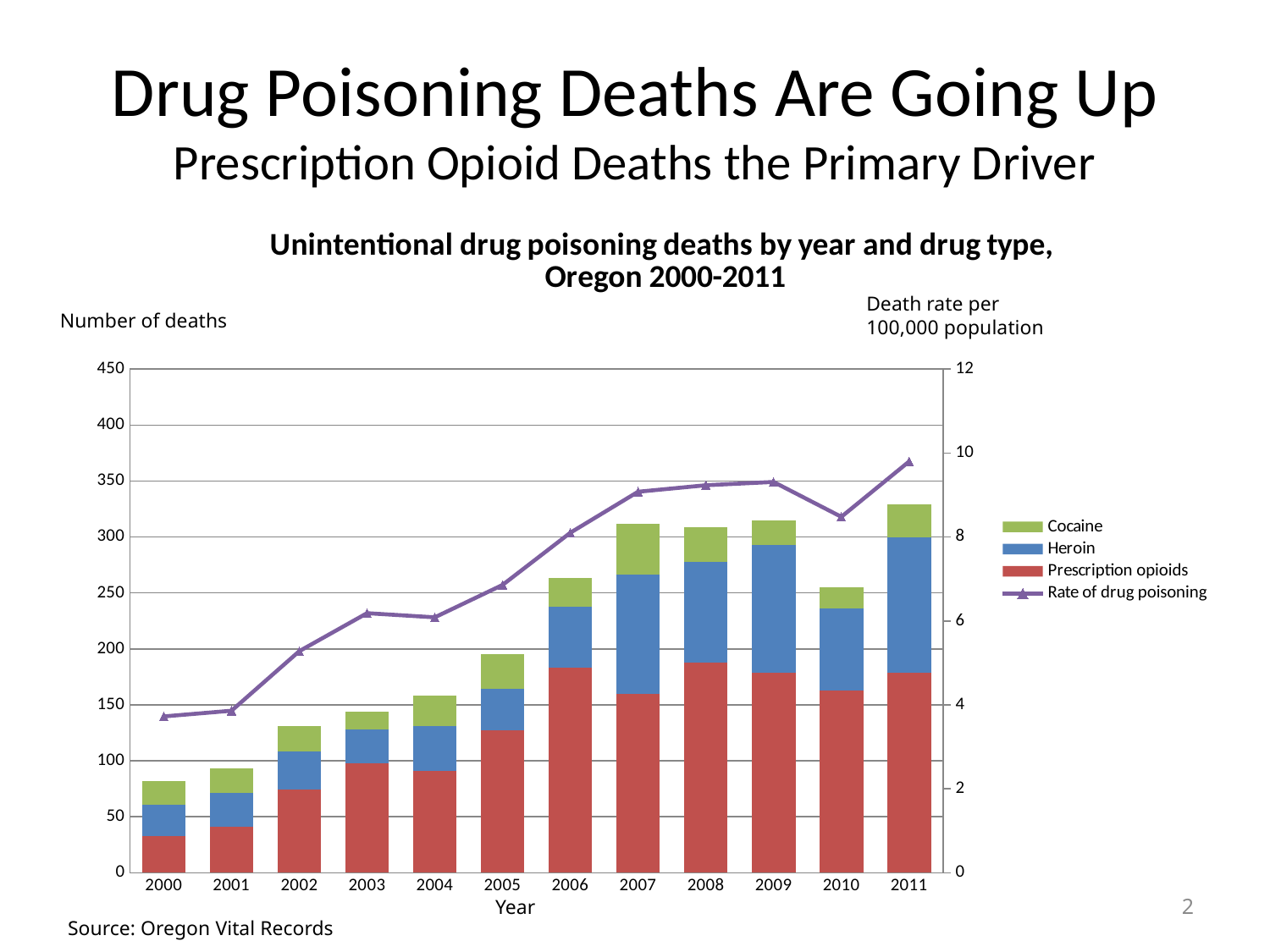
How many years are shown on the x axis of the chart? 12 Is the total number of deaths in 2011 greater or less than 300? greater Which year has the shortest stacked bar for total unintentional drug poisoning deaths? 2000 Which series in the legend is shown in red? Prescription opioids How many series does the chart's legend list? 4 Is the total number of deaths in 2000 greater or less than 100? less Does the rate of drug poisoning generally rise or fall from 2000 to 2011? rise Is the rate of drug poisoning in 2000 greater or less than 4 per 100,000 population? less Which year has the larger total number of deaths, 2007 or 2010? 2007 What kind of chart is shown on the slide? A stacked bar chart with a line Which year has the tallest stacked bar for total unintentional drug poisoning deaths? 2011